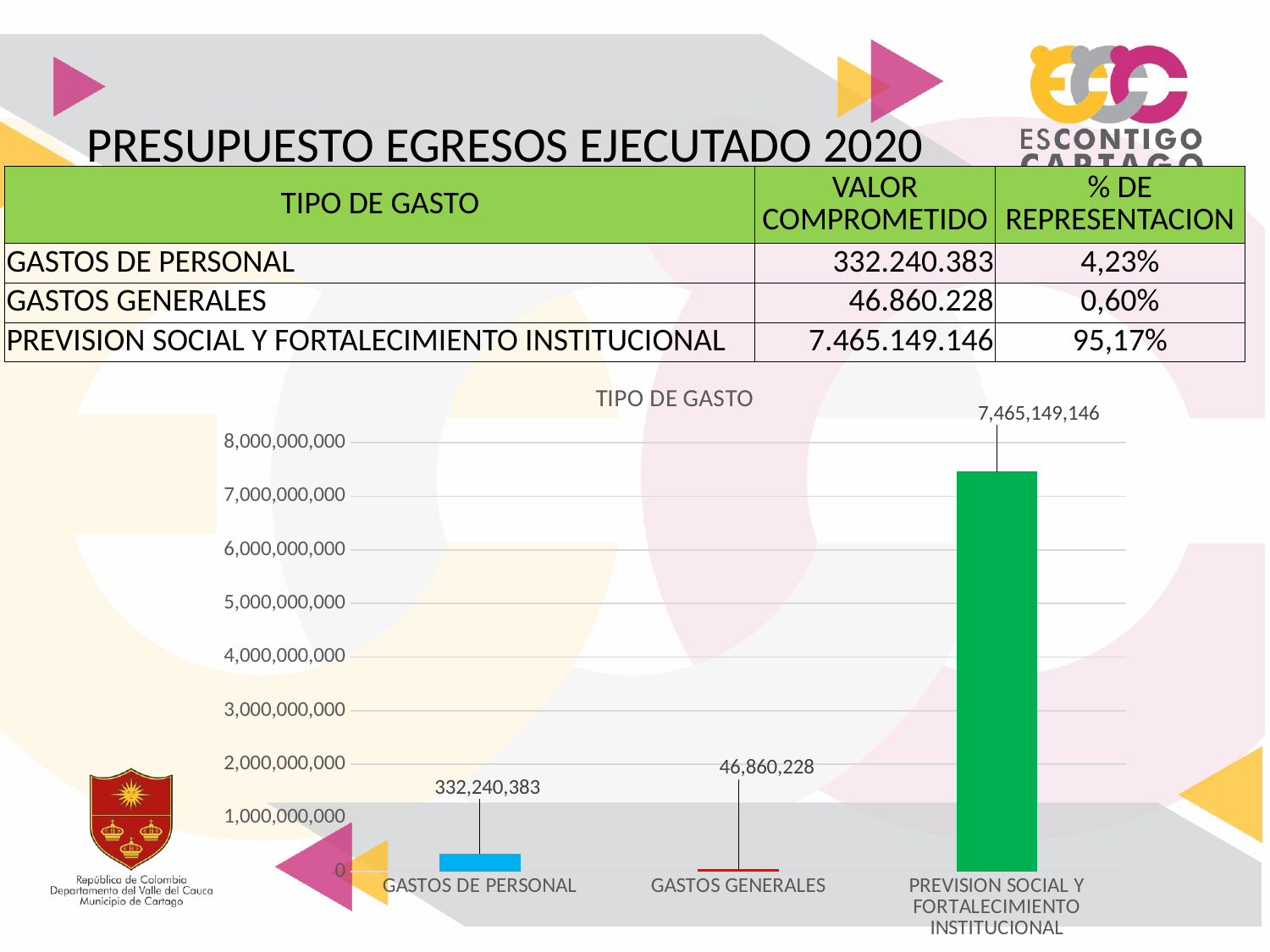
What is the value for GASTOS GENERALES in the chart? 46,860,228 What is the difference between the values for GASTOS DE PERSONAL and GASTOS GENERALES? 285,380,155 Is the value for PREVISION SOCIAL Y FORTALECIMIENTO INSTITUCIONAL greater or less than 7,000,000,000? greater What is the value for PREVISION SOCIAL Y FORTALECIMIENTO INSTITUCIONAL in the chart? 7,465,149,146 Which is larger, the value for GASTOS DE PERSONAL or the value for GASTOS GENERALES? GASTOS DE PERSONAL What is the title of the chart? TIPO DE GASTO Which category has the lowest value in the chart? GASTOS GENERALES How many categories are shown in the chart? 3 What is the difference between the values for PREVISION SOCIAL Y FORTALECIMIENTO INSTITUCIONAL and GASTOS DE PERSONAL? 7,132,908,763 Which category has the highest value in the chart? PREVISION SOCIAL Y FORTALECIMIENTO INSTITUCIONAL What is the value for GASTOS DE PERSONAL in the chart? 332,240,383 What kind of chart is shown on the slide? bar chart